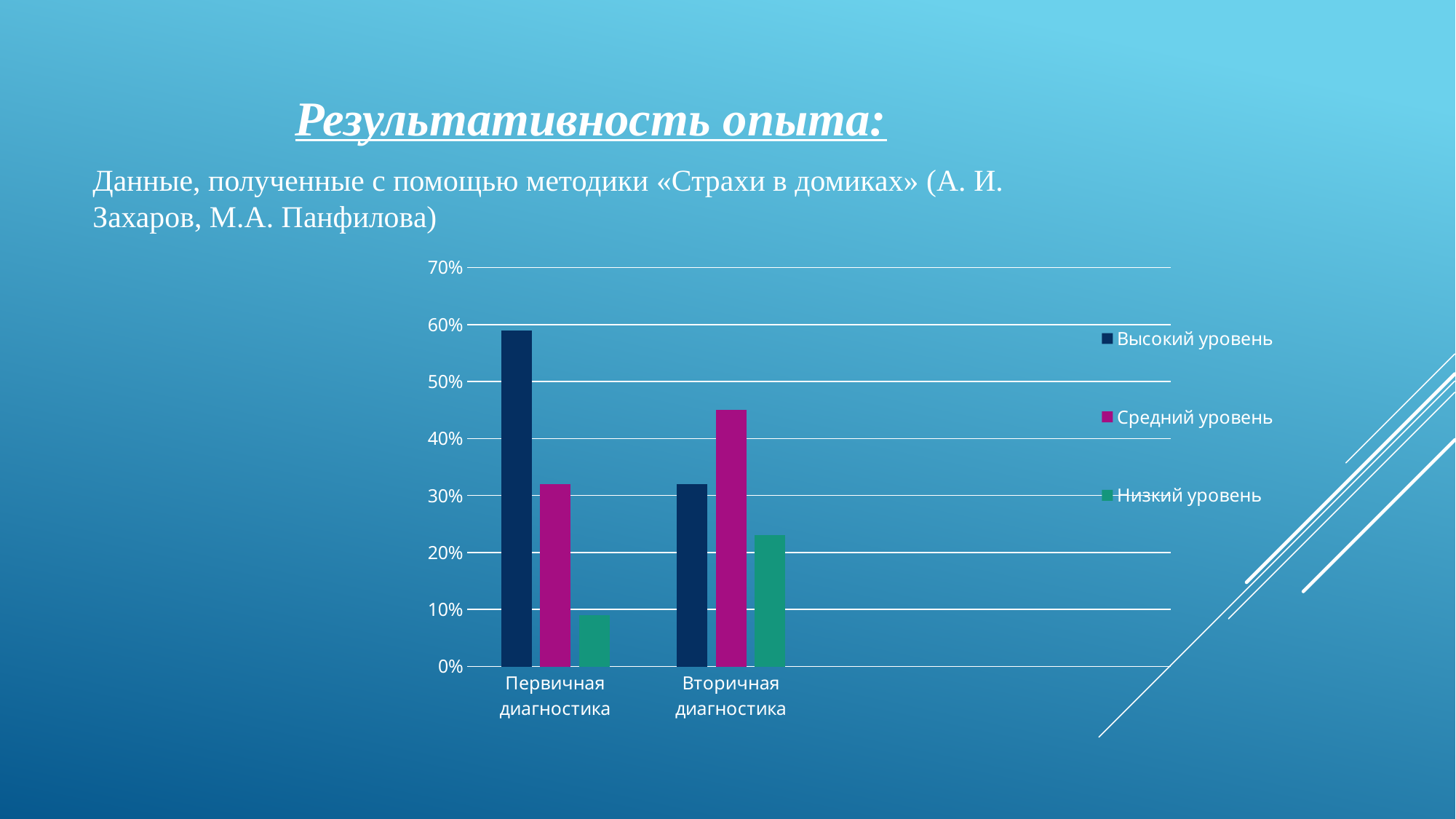
Is the value for Средний уровень in Вторичная диагностика greater or less than 40%? greater Which is larger: Высокий уровень in Первичная диагностика or Высокий уровень in Вторичная диагностика? Первичная диагностика Which legend entry is shown in magenta? Средний уровень Which series has the highest value for Первичная диагностика? Высокий уровень Which series has the highest value for Вторичная диагностика? Средний уровень How many series does the chart legend list? 3 Which series has the lowest value for Первичная диагностика? Низкий уровень Is the value for Высокий уровень in Первичная диагностика greater or less than 50%? greater What kind of chart is shown on the slide? bar chart Which series has the lowest value for Вторичная диагностика? Низкий уровень How many categories are shown on the x axis of the chart? 2